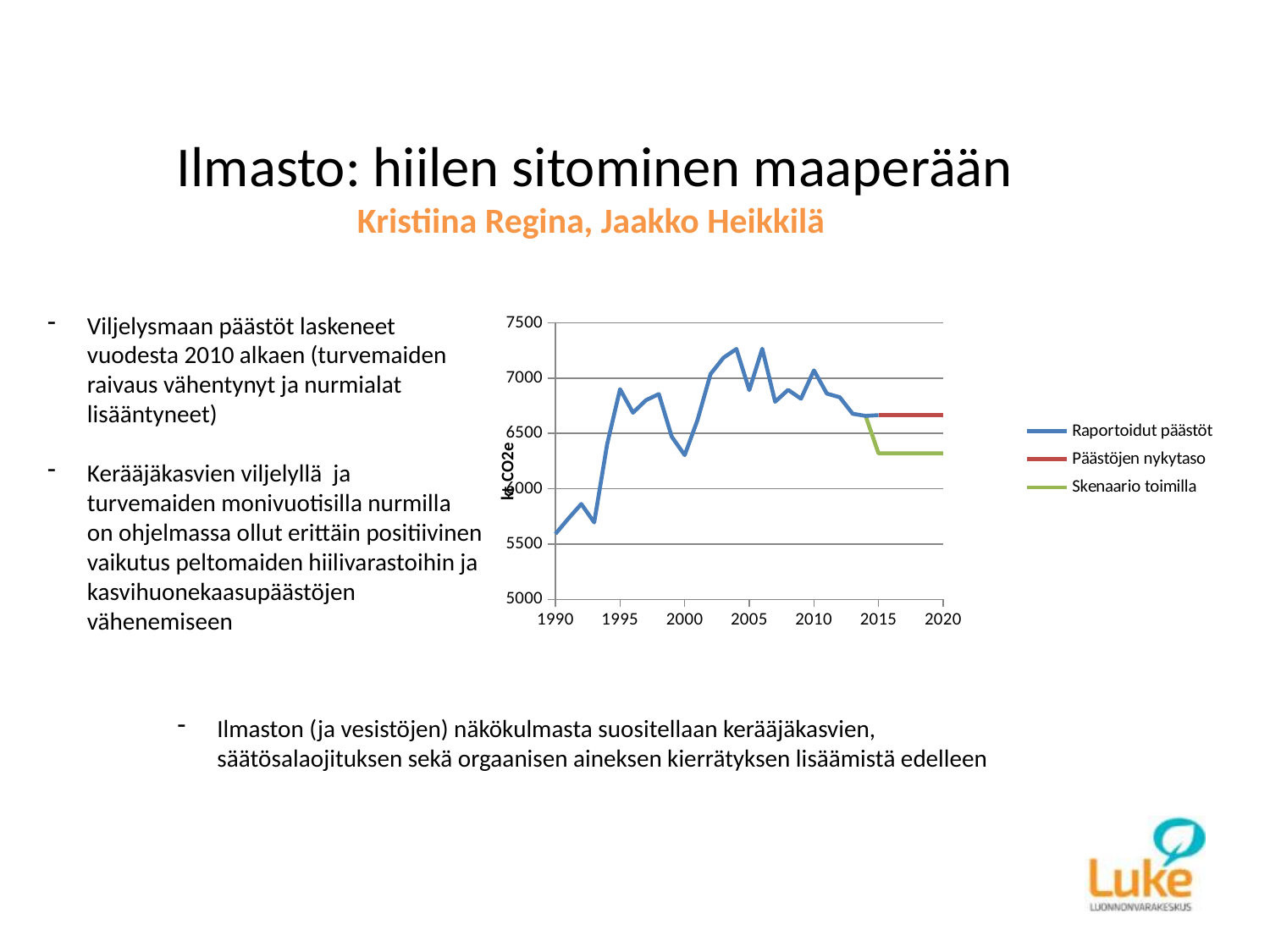
Do the values for Raportoidut päästöt rise or fall between 2010 and 2015? fall Which series is drawn in red in the chart? Päästöjen nykytaso In 2020, which series has the higher value, Päästöjen nykytaso or Skenaario toimilla? Päästöjen nykytaso Is the value for Raportoidut päästöt in 2004 greater or less than 7000? greater How many series does the chart legend list? 3 Is the value for Päästöjen nykytaso in 2020 greater or less than 6500? greater What kind of chart is shown on the slide? line chart Which series is drawn in green in the chart? Skenaario toimilla In which year does Raportoidut päästöt reach its lowest value? 1990 Do the values for Raportoidut päästöt rise or fall between 1990 and 1995? rise Is the value for Skenaario toimilla in 2020 greater or less than 6500? less